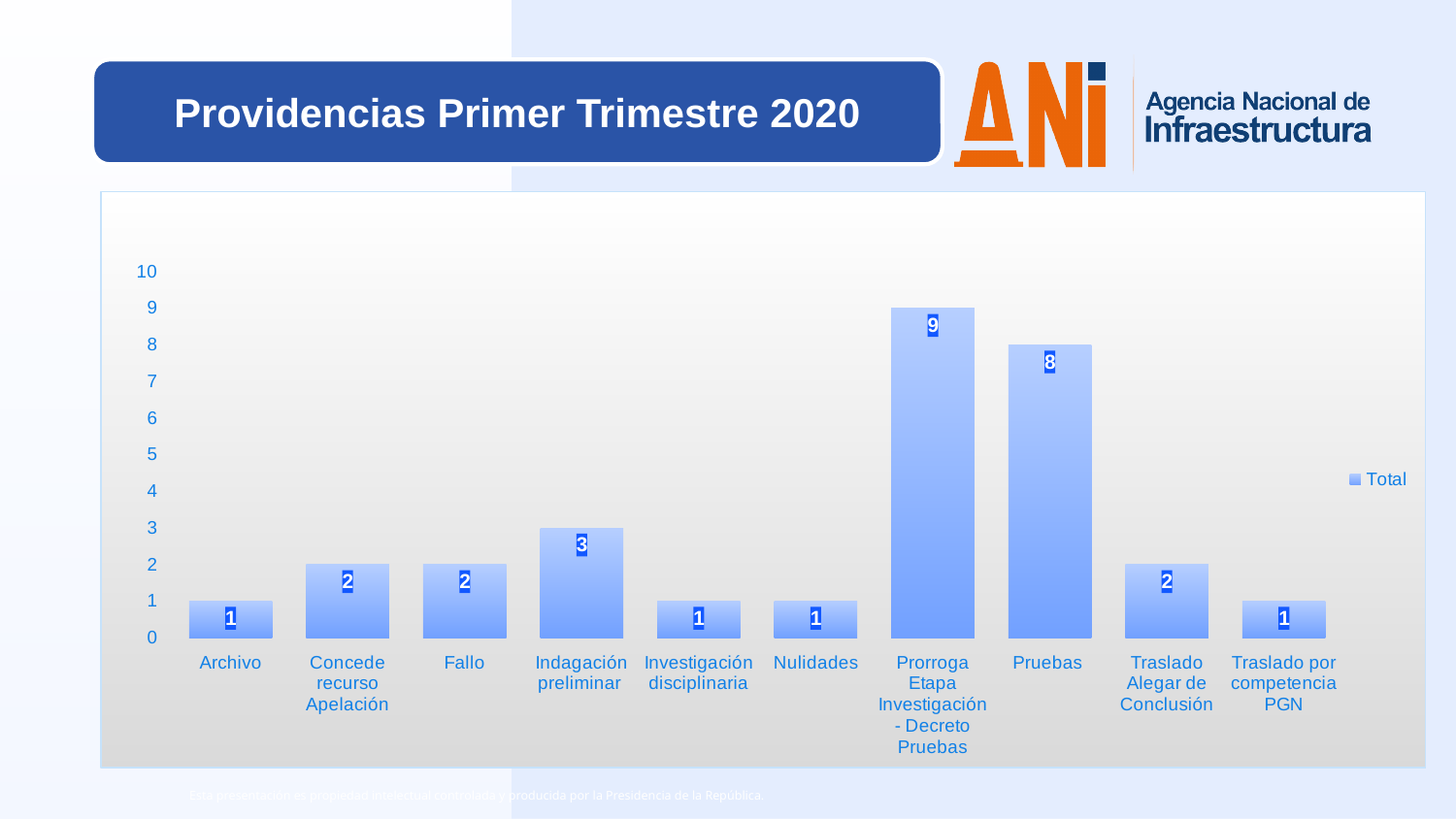
What is the value for Indagación preliminar? 3 How many categories are shown on the x axis? 10 Is the value for Pruebas greater or less than 5? greater What is the difference between the values for Prorroga Etapa Investigación - Decreto Pruebas and Pruebas? 1 What is the value for Traslado por competencia PGN? 1 What is the difference between the values for Indagación preliminar and Archivo? 2 What is the name of the series shown in the legend? Total How many series does the legend list? 1 Which category has the highest value? Prorroga Etapa Investigación - Decreto Pruebas What kind of chart is shown on the slide? bar chart Which is larger, the value for Fallo or the value for Nulidades? Fallo What is the value for Pruebas? 8